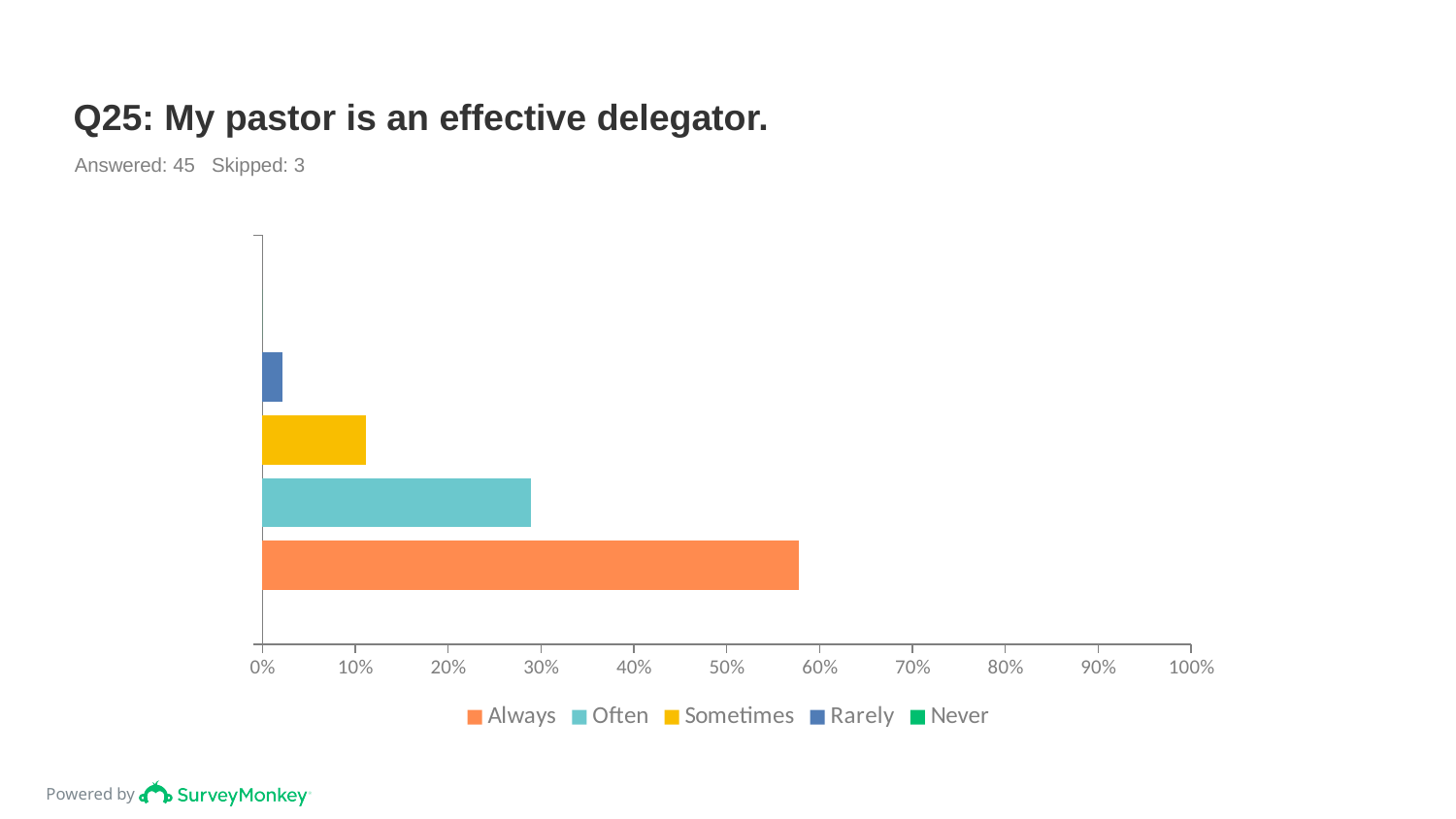
Is the value for Always greater or less than 50%? greater Is the value for Sometimes greater or less than 20%? less Which is larger, the value for Sometimes or the value for Rarely? Sometimes Which is larger, the value for Always or the value for Often? Always Is the value for Often greater or less than 20%? greater What kind of chart is shown on the slide? bar chart What is the title of the chart? Q25: My pastor is an effective delegator. How many respondents answered this question according to the slide? 45 How many entries does the legend list? 5 Which response category has the longest bar? Always